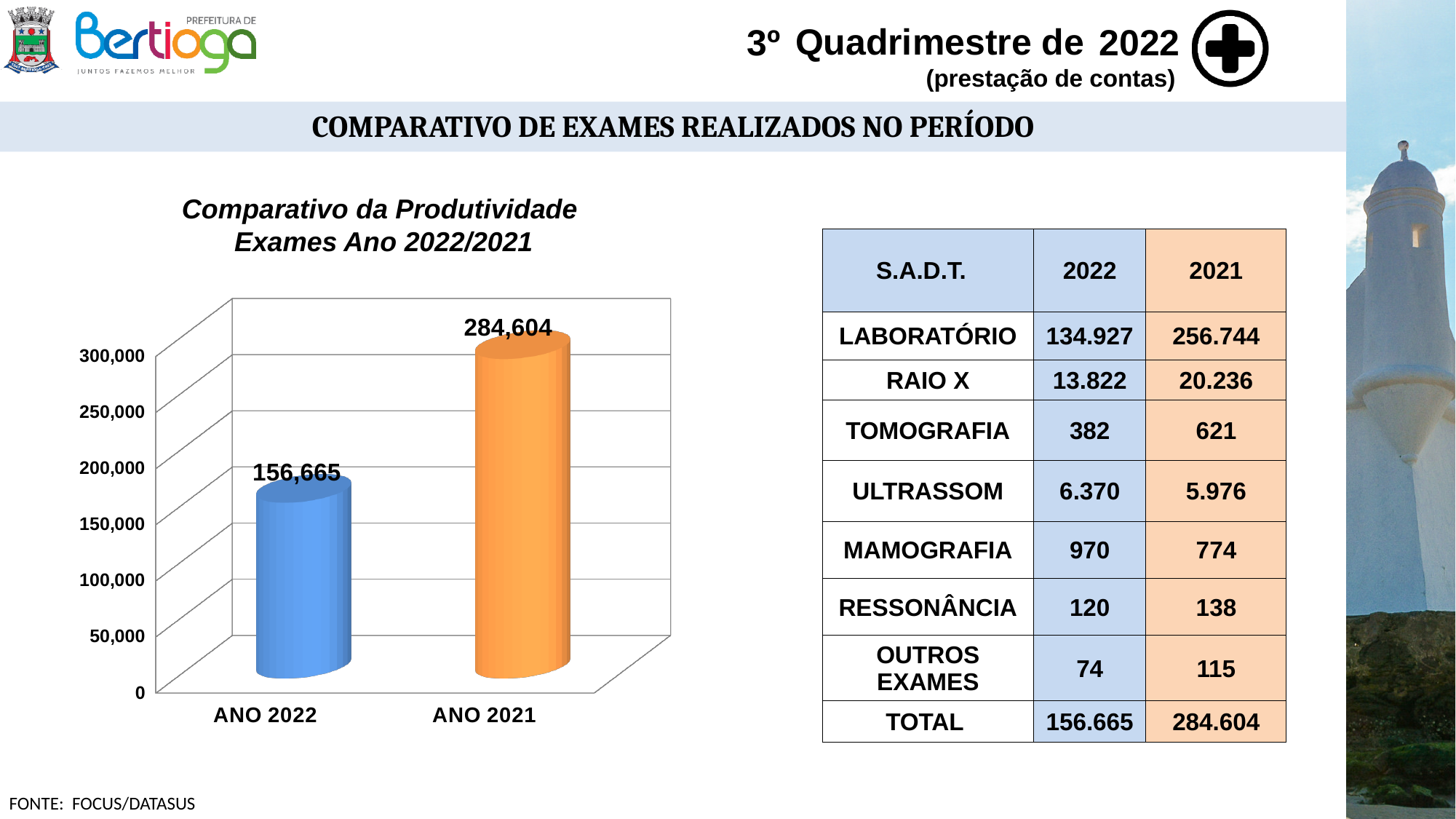
Do the values rise or fall from ANO 2022 to ANO 2021 along the x axis? rise What is the difference between the values for ANO 2021 and ANO 2022 in the chart? 127,939 Is the value for ANO 2022 greater or less than 200,000? less Which is larger in the chart, the value for ANO 2022 or the value for ANO 2021? ANO 2021 What is the title of the chart? Comparativo da Produtividade Exames Ano 2022/2021 Is the value for ANO 2021 greater or less than 250,000? greater Which category has the highest value in the chart? ANO 2021 Which category has the lowest value in the chart? ANO 2022 How many categories are plotted in the chart? 2 What is the value shown for ANO 2021 in the chart? 284,604 What kind of chart is shown on the slide? bar chart What is the value shown for ANO 2022 in the chart? 156,665